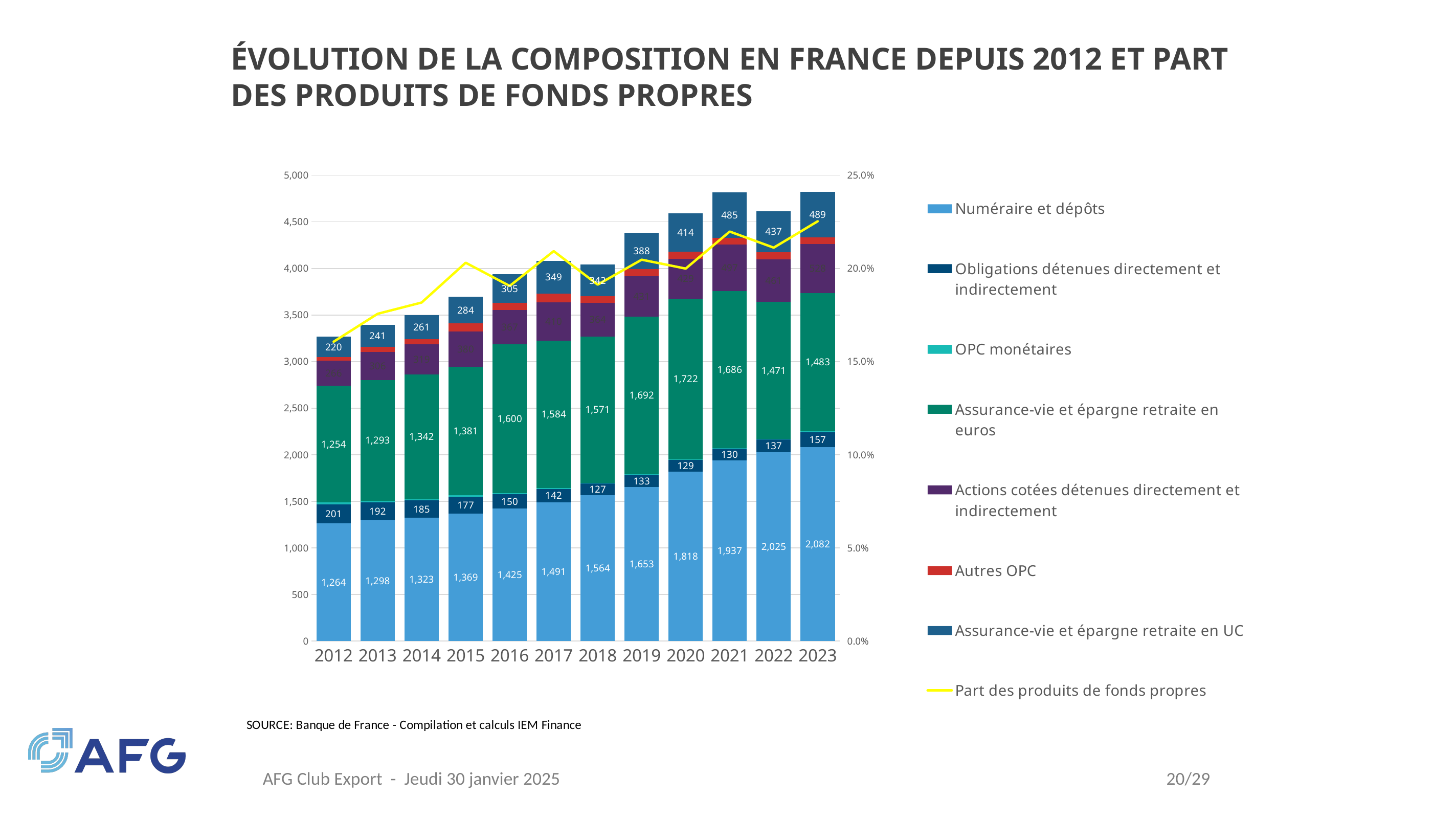
How many years are shown on the x axis? 12 In which year is Numéraire et dépôts highest? 2023 Which year has the larger value for Assurance-vie et épargne retraite en euros, 2019 or 2020? 2020 Is the Part des produits de fonds propres for 2023 greater or less than 20.0%? greater What is the value of Numéraire et dépôts for 2023? 2,082 By how much did Numéraire et dépôts increase from 2012 to 2023? 818 In which year is Obligations détenues directement et indirectement lowest? 2018 What is the value of Assurance-vie et épargne retraite en UC for 2021? 485 What is the value of Obligations détenues directement et indirectement for 2012? 201 What is the value of Assurance-vie et épargne retraite en euros for 2020? 1,722 What is the difference between Assurance-vie et épargne retraite en UC in 2023 and 2022? 52 How many series does the legend list? 8